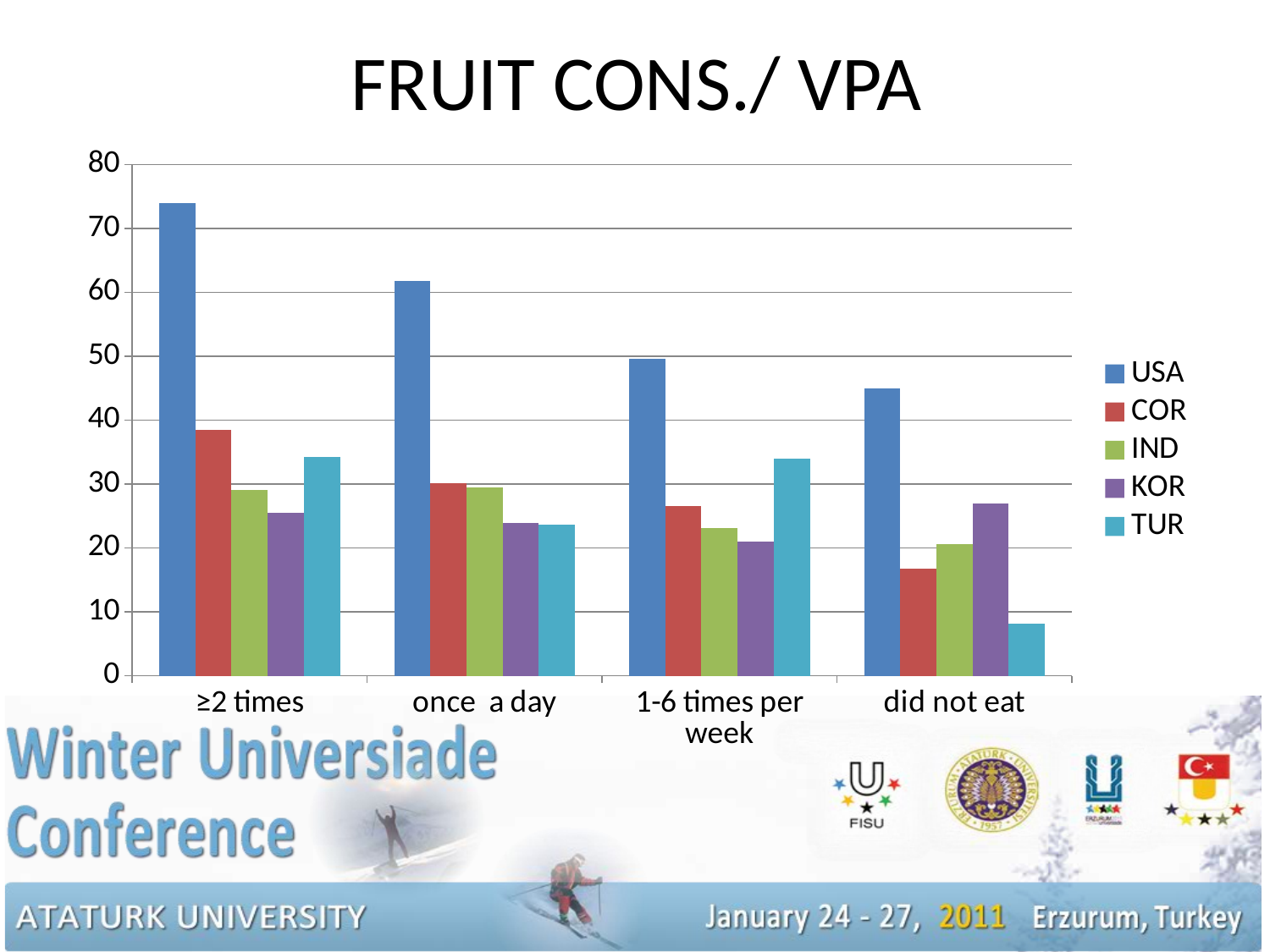
Is the USA value for '≥2 times' greater or less than 70? greater In which category is the TUR value lowest? did not eat How many series does the legend list? 5 Is the USA value for 'did not eat' greater or less than 40? greater Which series has the lowest value in the 'did not eat' category? TUR In the 'did not eat' category, which is larger, KOR or TUR? KOR How many fruit consumption categories are shown on the x axis? 4 In which category is the USA value highest? ≥2 times In the '≥2 times' category, which is larger, COR or IND? COR Is the TUR value for 'did not eat' greater or less than 10? less Do the USA values rise or fall moving from '≥2 times' to 'did not eat' along the x axis? fall What kind of chart is shown on the slide? bar chart